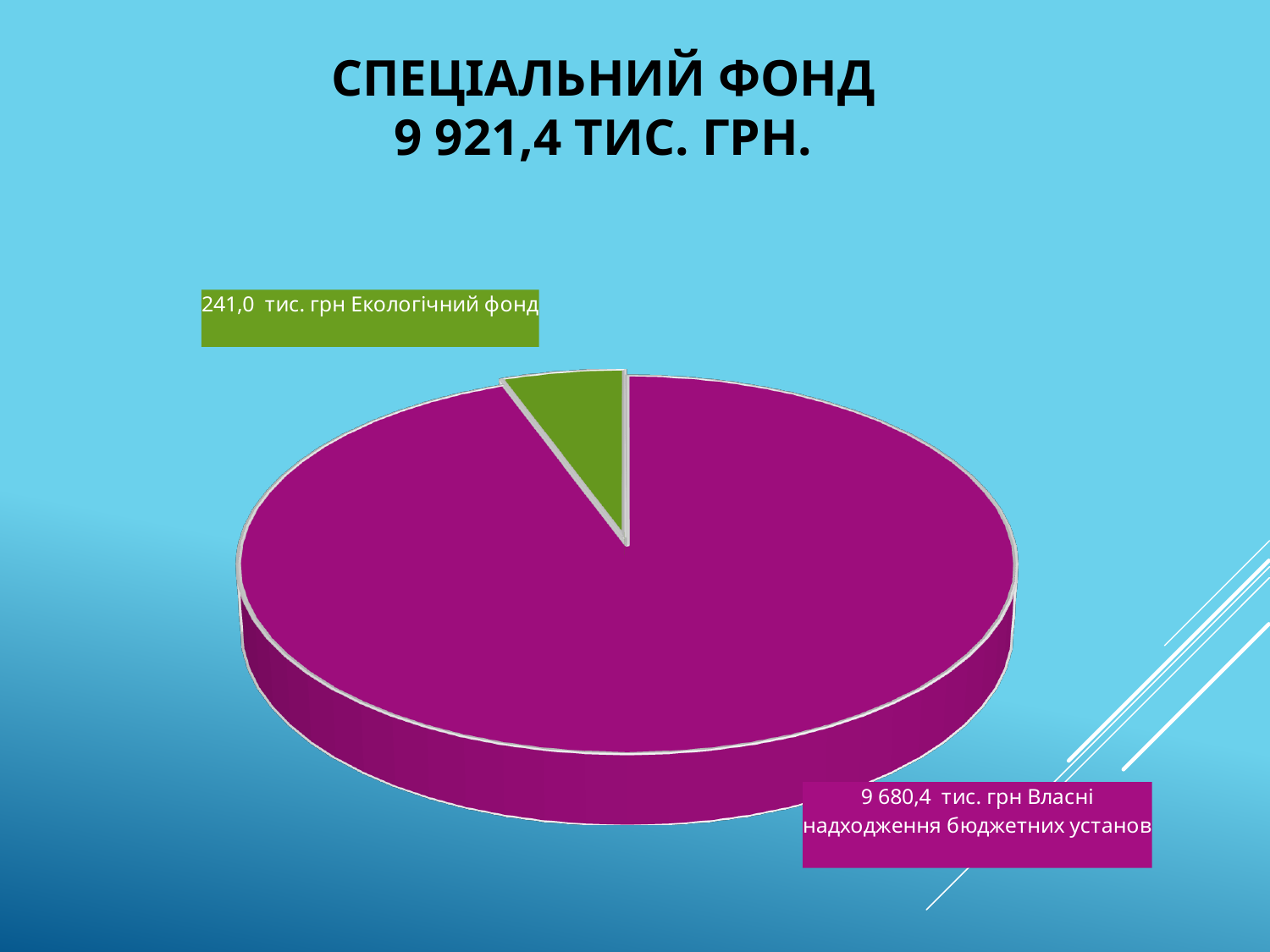
What colour is the Екологічний фонд slice? green What is the value of the Власні надходження бюджетних установ slice? 9 680,4 тис. грн How many slices does the pie chart have? 2 What type of chart is shown on the slide? pie chart What is the title of the chart? СПЕЦІАЛЬНИЙ ФОНД 9 921,4 ТИС. ГРН. What is the value of the Екологічний фонд slice? 241,0 тис. грн Which is larger: Екологічний фонд or Власні надходження бюджетних установ? Власні надходження бюджетних установ What is the difference between Власні надходження бюджетних установ and Екологічний фонд? 9 439,4 тис. грн Which slice of the pie chart is the largest? Власні надходження бюджетних установ Which slice of the pie chart is the smallest? Екологічний фонд What is the total of the special fund shown in the chart title? 9 921,4 тис. грн